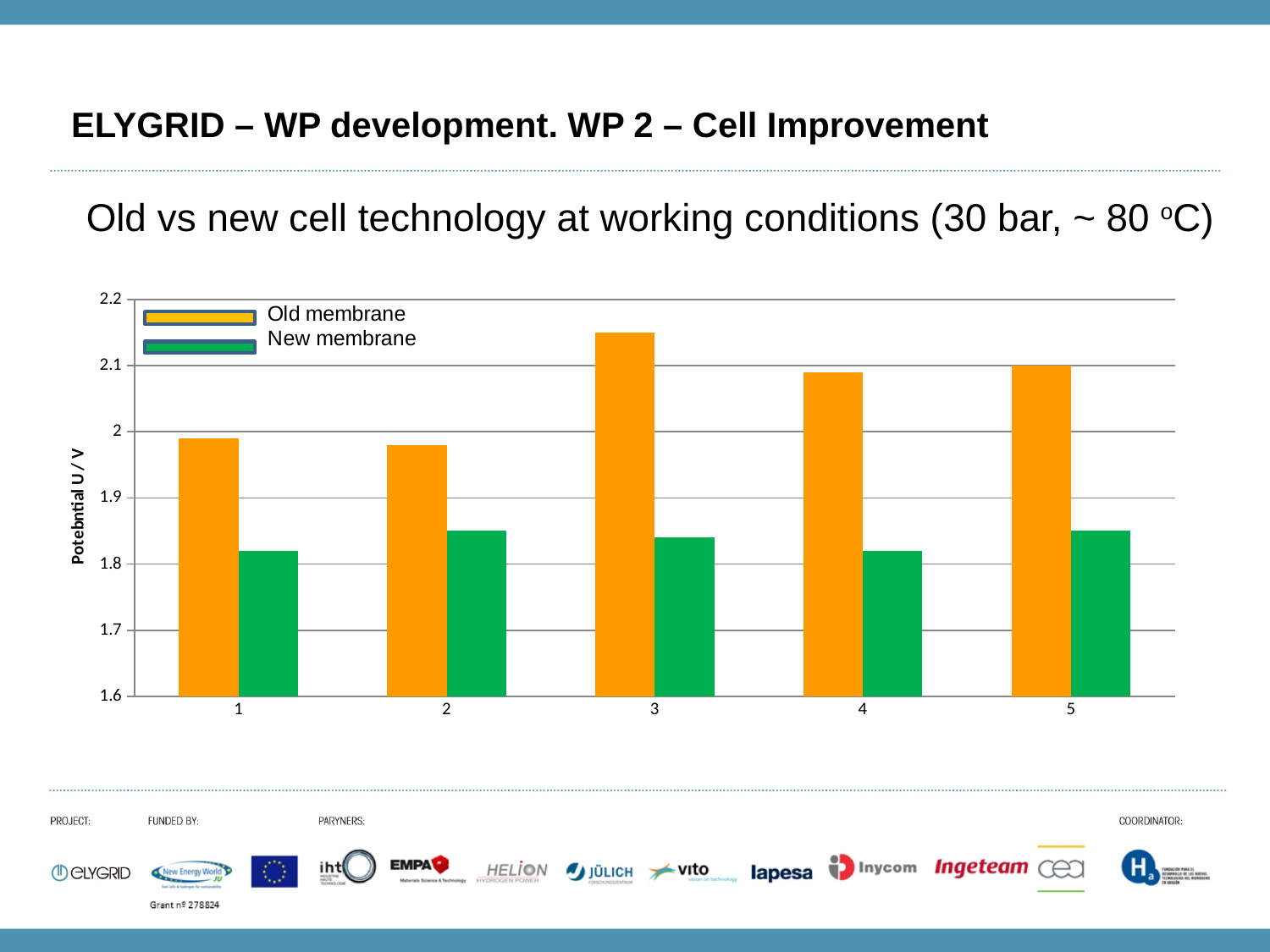
Is the Old membrane value for category 4 greater or less than 2? greater How many series does the legend list? 2 For category 3, which series has the larger value, Old membrane or New membrane? Old membrane What colour are the New membrane bars? green What kind of chart is shown on the slide? bar chart Is the New membrane value for category 1 greater or less than 1.9? less How many categories are shown on the x axis? 5 Is the New membrane value for category 2 greater or less than 1.8? greater Which is larger, the Old membrane value for category 1 or for category 4? category 4 What are the two entries in the legend? Old membrane, New membrane Which category has the highest Old membrane value? 3